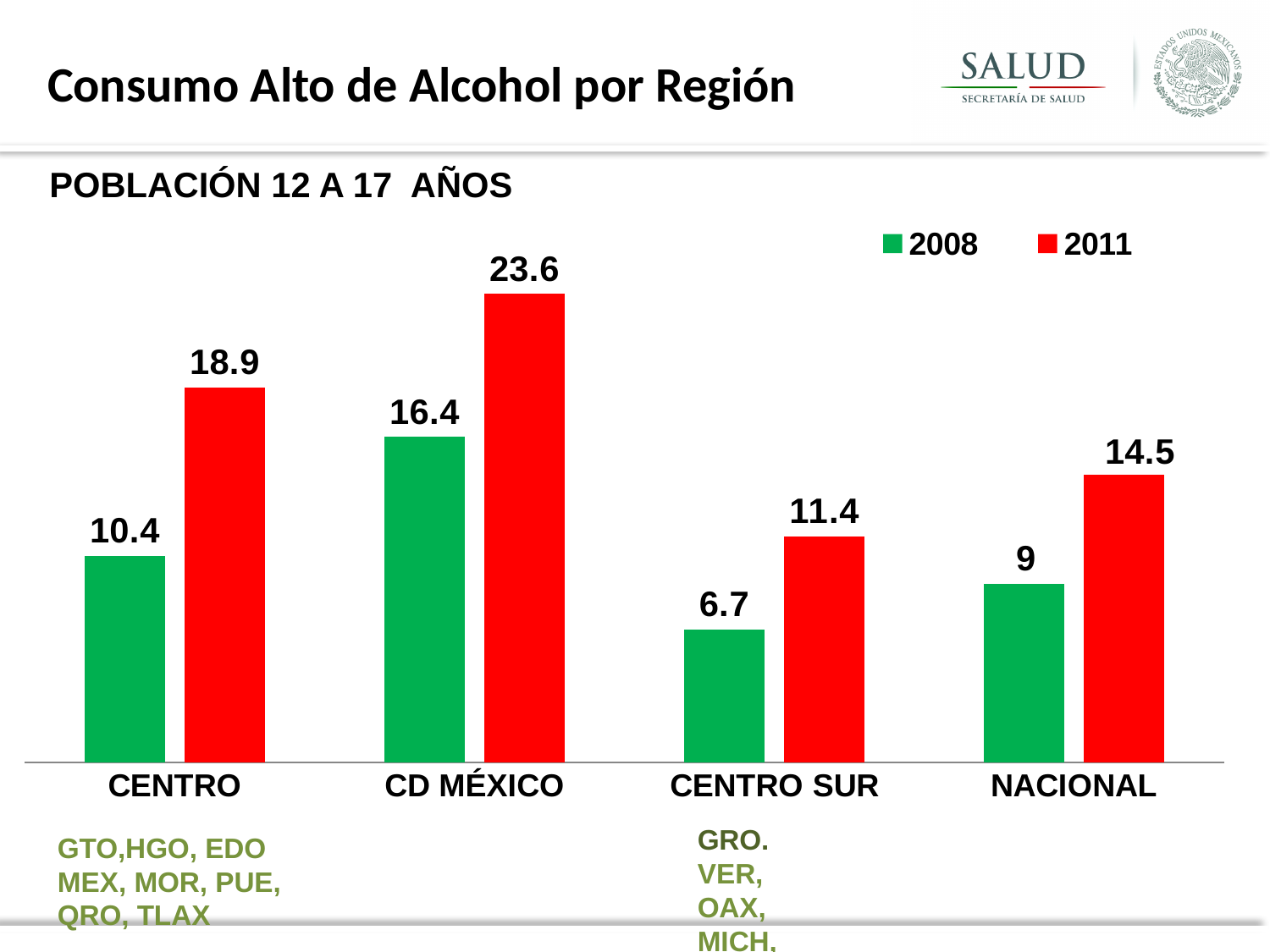
How many regions are shown on the x axis? 4 Which colour represents the 2011 series in the legend? Red Which is larger: the 2008 value for CD MÉXICO or the 2011 value for CENTRO SUR? 2008 value for CD MÉXICO What is the 2011 value for CD MÉXICO? 23.6 What is the 2008 value for NACIONAL? 9 How many series does the legend list? 2 What is the difference between the 2011 values for CD MÉXICO and NACIONAL? 9.1 Which region has the highest 2011 value? CD MÉXICO What is the 2008 value for CENTRO SUR? 6.7 What kind of chart is shown on the slide? Bar chart Which region has the lowest 2008 value? CENTRO SUR What is the difference between the 2011 and 2008 values for CENTRO? 8.5